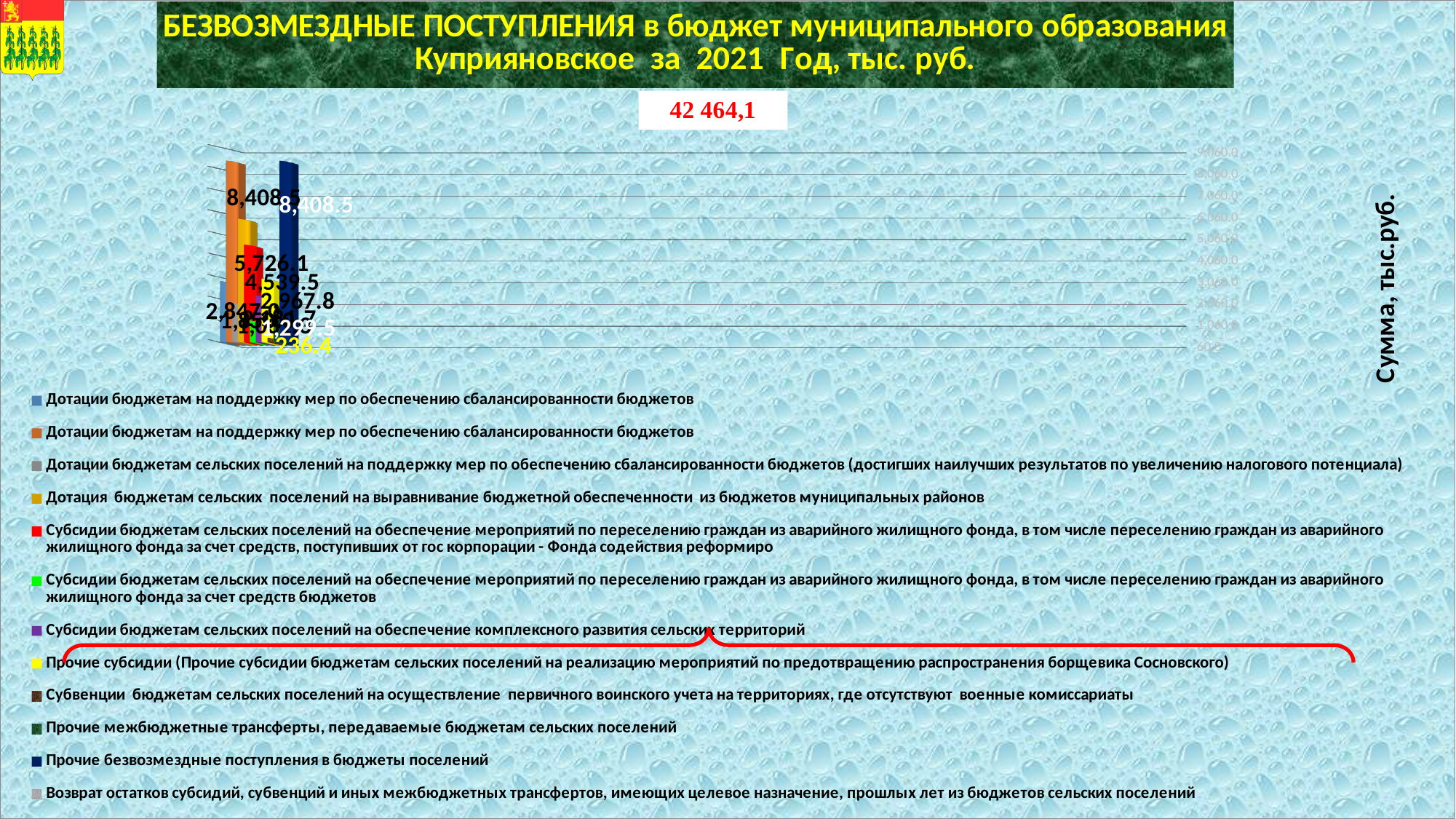
Is the value 5,726.1 on the chart greater or less than 5,000.0? greater How many series does the chart legend list? 12 What kind of chart is shown on the slide? bar chart What is the title of the slide's chart? БЕЗВОЗМЕЗДНЫЕ ПОСТУПЛЕНИЯ в бюджет муниципального образования Куприяновское за 2021 Год, тыс. руб. What is the difference between the data labels 5,726.1 and 4,539.5 on the chart? 1,186.6 What is the label on the vertical axis of the chart? Сумма, тыс.руб. Is the value 236.4 on the chart greater or less than 1,000.0? less Which is larger on the chart, the value 4,539.5 or the value 2,967.8? 4,539.5 What is the difference between the data labels 8,408.5 and 5,726.1 on the chart? 2,682.4 What is the largest data label value shown on the chart? 8,408.5 What is the smallest data label value shown on the chart? 236.4